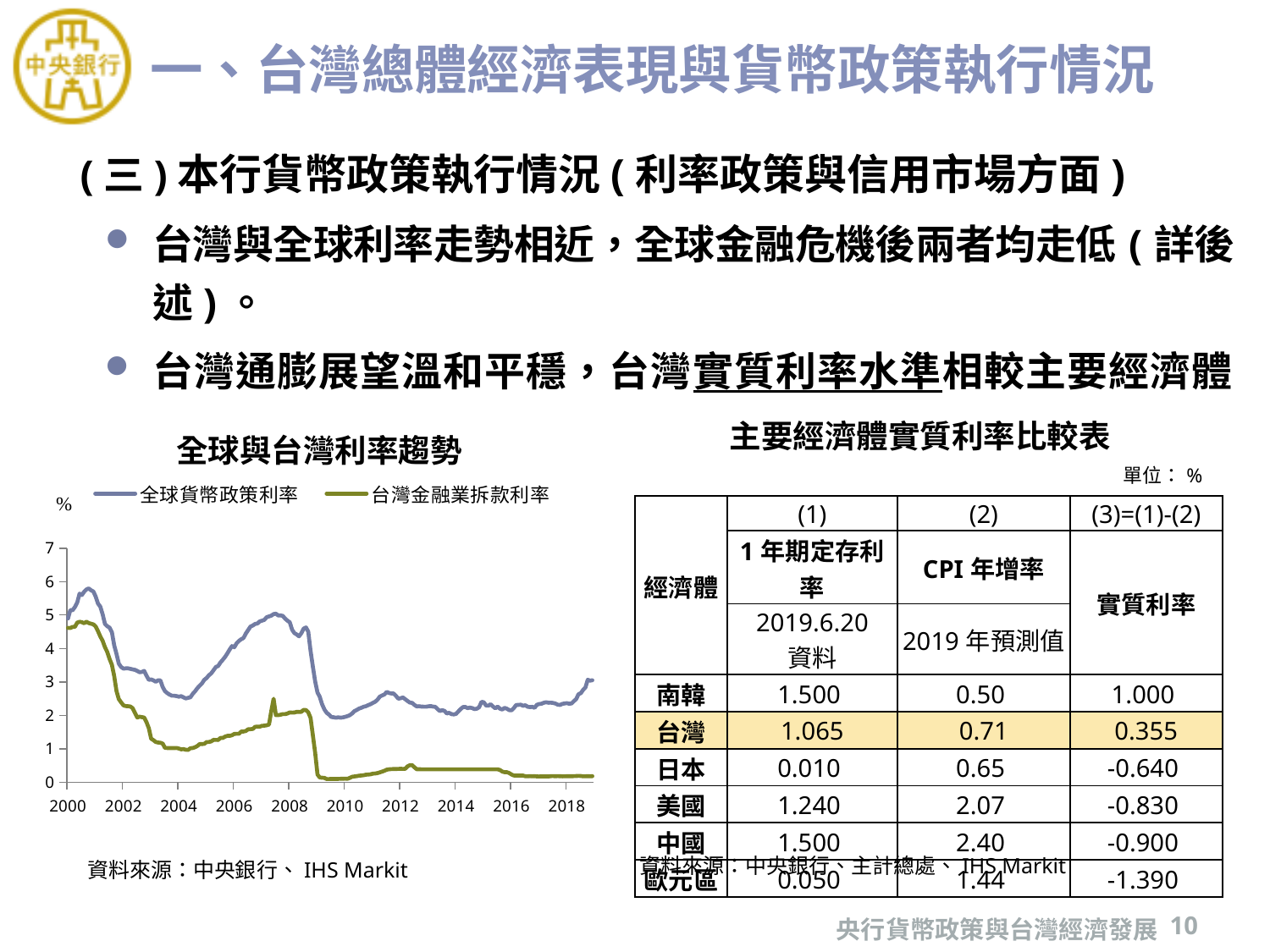
In the '全球與台灣利率趨勢' chart, which series is higher in 2018, 全球貨幣政策利率 or 台灣金融業拆款利率? 全球貨幣政策利率 What kind of chart is the '全球與台灣利率趨勢' chart? line chart In the '全球與台灣利率趨勢' chart, is the value of 全球貨幣政策利率 in 2008 greater or less than 4? greater How many year labels are shown on the x axis of the '全球與台灣利率趨勢' chart? 10 What are the two series named in the legend of the '全球與台灣利率趨勢' chart? 全球貨幣政策利率 and 台灣金融業拆款利率 How many series does the legend of the '全球與台灣利率趨勢' chart list? 2 In the '全球與台灣利率趨勢' chart, does 全球貨幣政策利率 rise or fall between 2004 and 2008? rise What unit is shown on the y axis of the '全球與台灣利率趨勢' chart? % In the '全球與台灣利率趨勢' chart, is the value of 全球貨幣政策利率 in 2000 greater or less than 4? greater In the '全球與台灣利率趨勢' chart, is the value of 台灣金融業拆款利率 in 2018 greater or less than 1? less In the '全球與台灣利率趨勢' chart, does 台灣金融業拆款利率 rise or fall between 2000 and 2004? fall